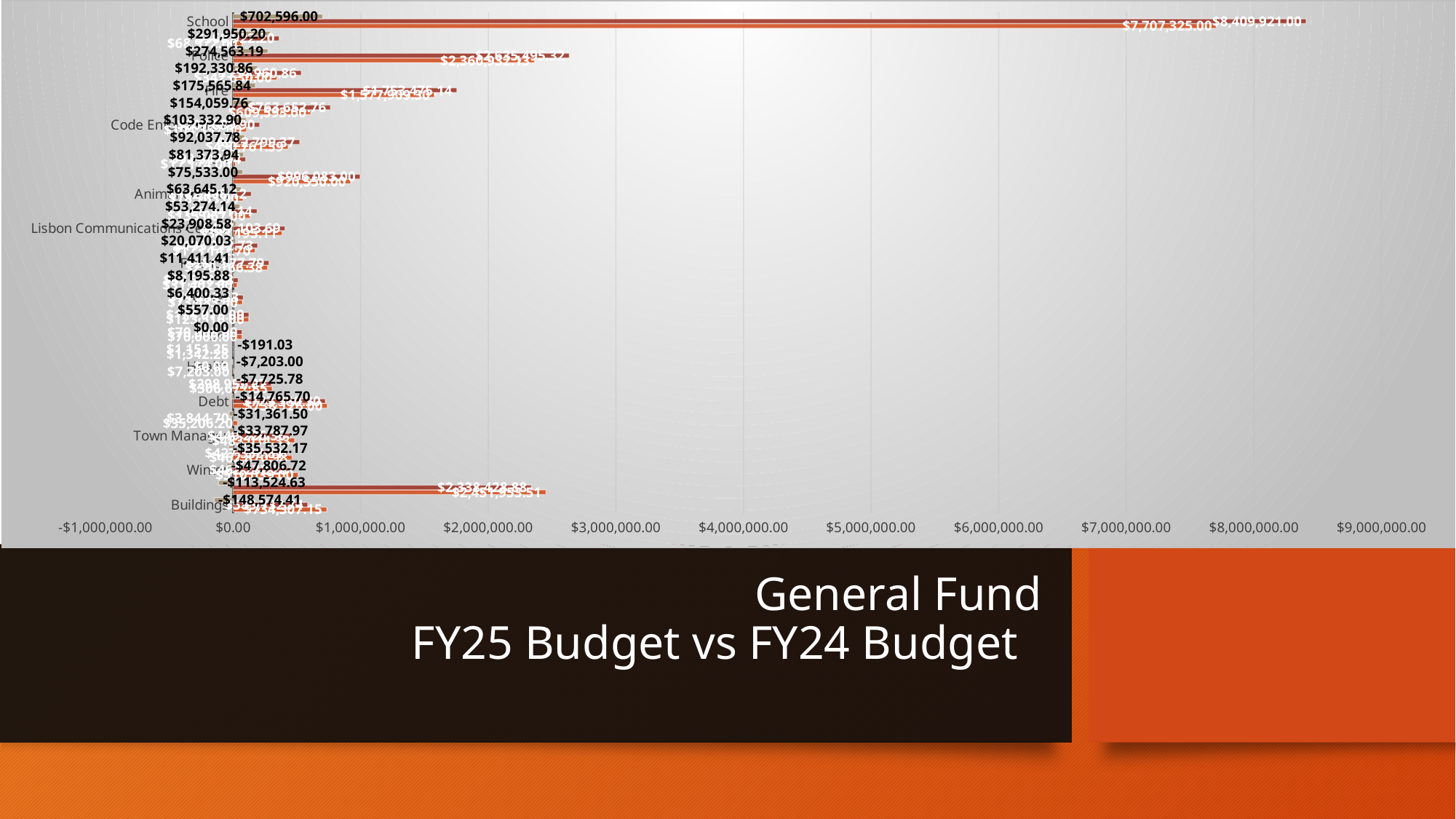
Is the longest Debt bar greater or less than $1,000,000.00? less What kind of chart is shown on the slide? bar chart Is the longest School bar greater or less than $7,000,000.00? greater What is the title shown beneath the chart? General Fund FY25 Budget vs FY24 Budget What is the second value labelled on the School bars? $7,707,325.00 What is the black difference label shown for School? $702,596.00 What is the largest value labelled for School? $8,409,921.00 Is the longest Buildings bar greater or less than $3,000,000.00? less What is the highest tick value shown on the horizontal axis? $9,000,000.00 What is the black difference label shown for Buildings? -$148,574.41 Which has a longer bar, School or Buildings? School Which category has the longest bar in the chart? School